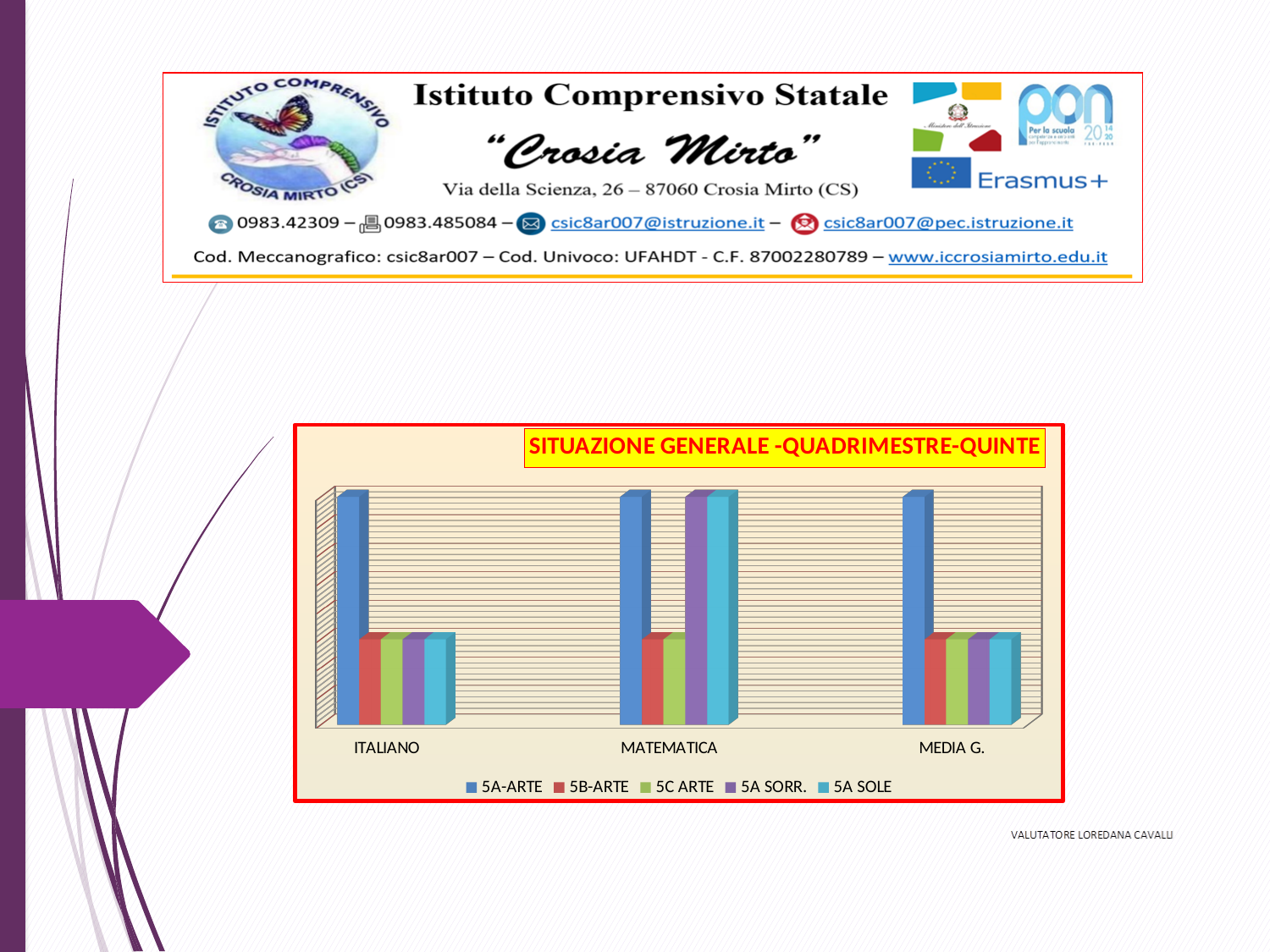
In the MATEMATICA category, which is larger: the bar for 5C ARTE or the bar for 5A SOLE? 5A SOLE How many series does the chart legend list? 5 How many categories are shown on the x axis of the chart? 3 Which series has the highest bar in the MEDIA G. category? 5A-ARTE What kind of chart is shown on the slide? bar chart In the MEDIA G. category, which is larger: the bar for 5A-ARTE or the bar for 5A SOLE? 5A-ARTE Which series has the highest bar in the ITALIANO category? 5A-ARTE Which colour represents the 5A SORR. series in the chart legend? purple What is the title of the chart? SITUAZIONE GENERALE -QUADRIMESTRE-QUINTE In the ITALIANO category, which is larger: the bar for 5A-ARTE or the bar for 5B-ARTE? 5A-ARTE